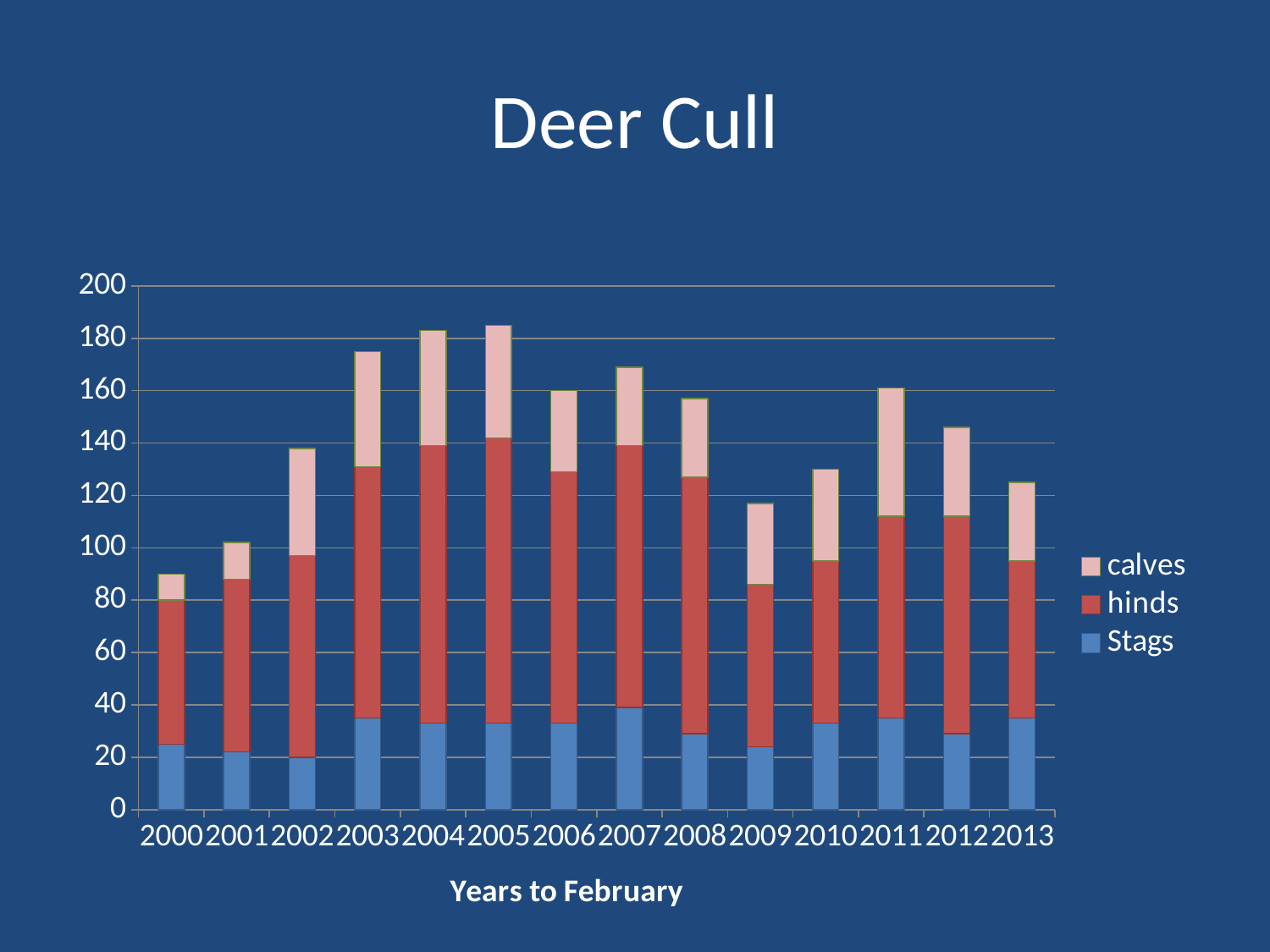
How many years are shown along the x axis? 14 Which year has the lowest total deer cull? 2000 Is the Stags value for 2007 greater or less than 20? greater Is the total deer cull for 2000 greater or less than 100? less Which year has the larger total deer cull, 2002 or 2003? 2003 Is the total deer cull for 2010 greater or less than 140? less Do the total deer cull values rise or fall from 2005 to 2009? fall What is the title of the x axis? Years to February Which year has the larger total deer cull, 2009 or 2010? 2010 How many series does the legend list? 3 What kind of chart is shown on the slide? Stacked bar chart